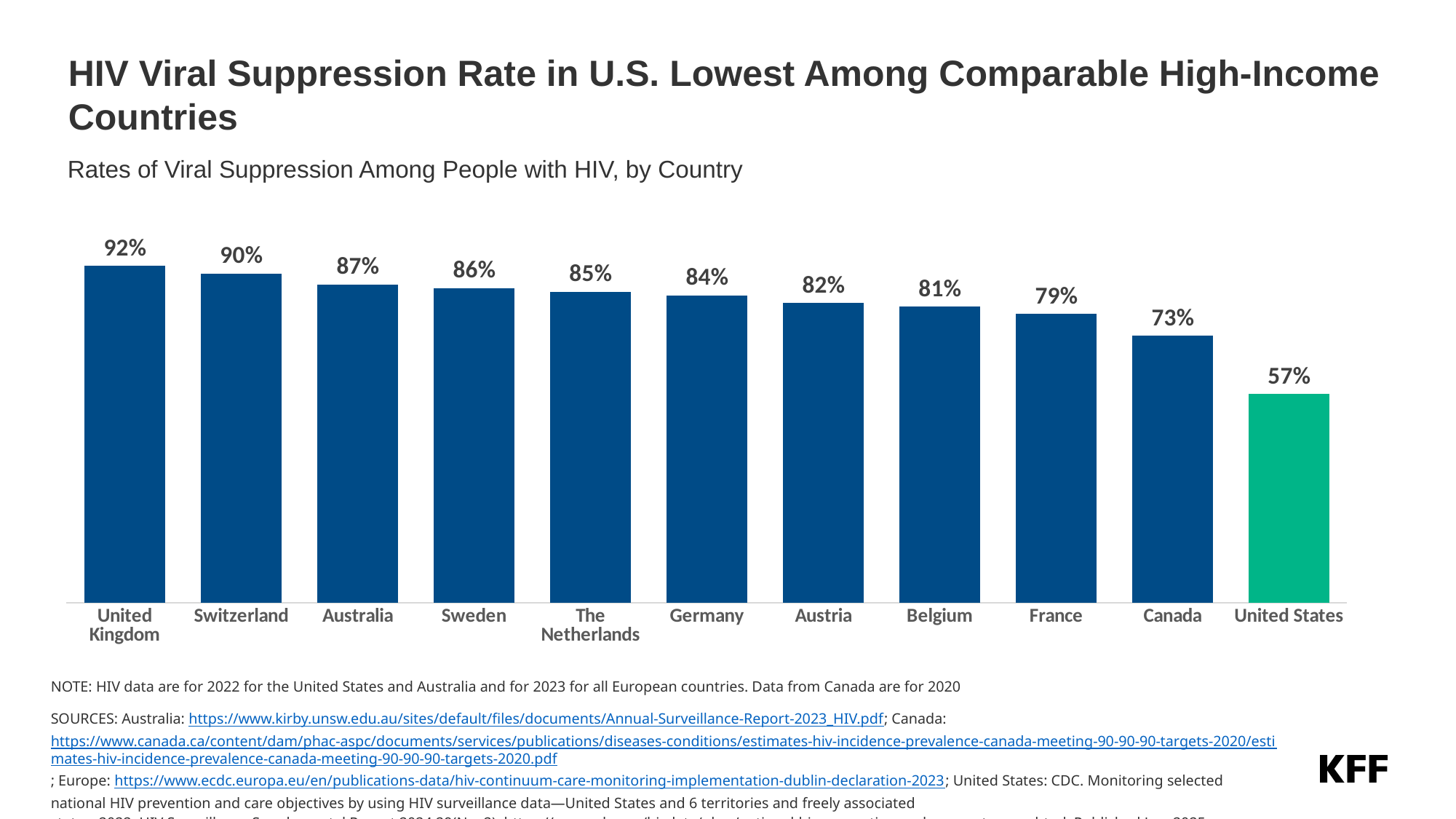
Which country's bar is shown in a different colour (green) from the others? United States What is the difference between the viral suppression rates of the United Kingdom and the United States? 35 percentage points Which country has the lowest viral suppression rate? United States Which country has the highest viral suppression rate? United Kingdom What kind of chart is shown on the slide? Bar chart What is the viral suppression rate for The Netherlands? 85% What is the difference between the viral suppression rates of Canada and the United States? 16 percentage points What is the viral suppression rate for Canada? 73% How many countries are shown in the chart? 11 Which has a higher viral suppression rate, Germany or Belgium? Germany What is the viral suppression rate for the United Kingdom? 92% Which has a higher viral suppression rate, France or Canada? France